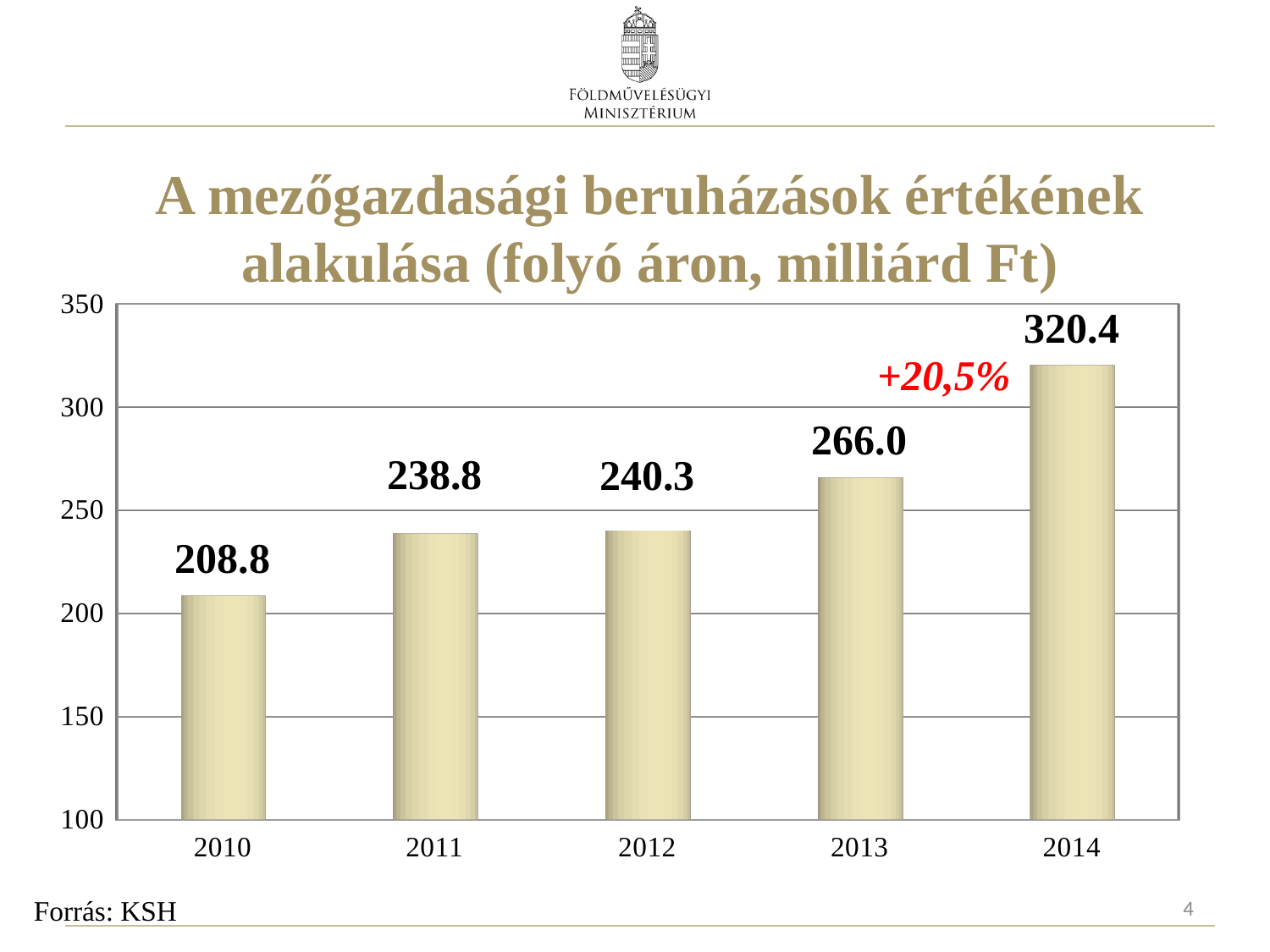
What is the difference between the values for 2014 and 2013? 54.4 What is the value for 2010? 208.8 What is the value for 2013? 266.0 Which is larger, the value for 2012 or the value for 2011? 2012 How many years are shown on the x axis? 5 Is the value for 2013 greater or less than 250? greater Do the values rise or fall from 2010 to 2014? rise What is the difference between the values for 2011 and 2010? 30.0 Which year has the highest value? 2014 What kind of chart is shown on the slide? bar chart What is the value for 2014? 320.4 Which year has the lowest value? 2010